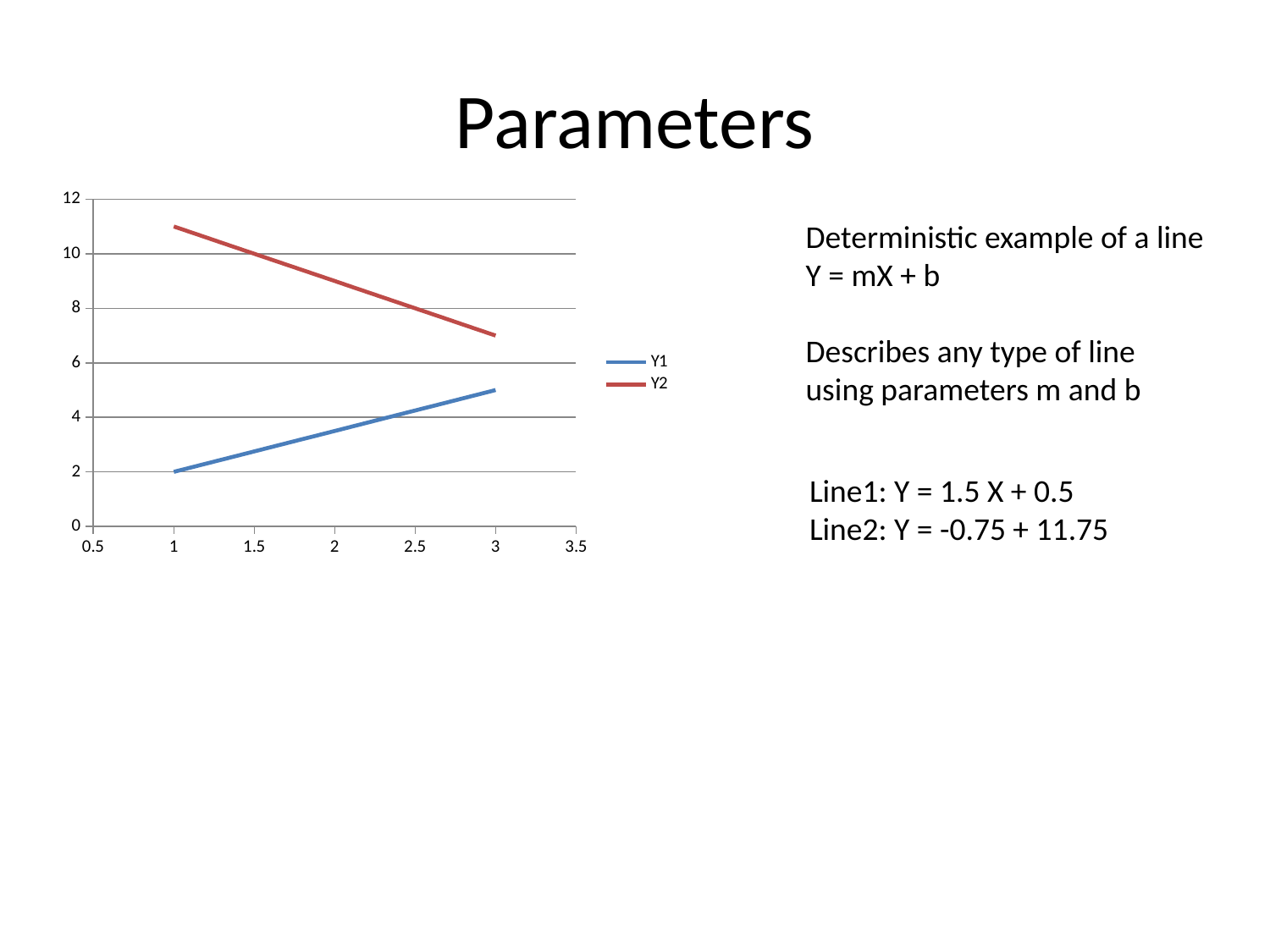
At x = 3, which series has the larger value, Y1 or Y2? Y2 Does Y2 rise or fall as x increases? fall What kind of chart is shown on the slide? line chart What is the value of Y1 at x = 1? 2 Is the value of Y2 at x = 3 greater or less than 8? less What colour is the Y2 line in the chart? red Is the value of Y1 at x = 3 greater or less than 4? greater Does Y1 rise or fall as x increases? rise What are the names of the series in the chart legend? Y1 and Y2 How many series does the chart legend list? 2 Is the value of Y2 at x = 1 greater or less than 10? greater At x = 1, which series has the larger value, Y1 or Y2? Y2